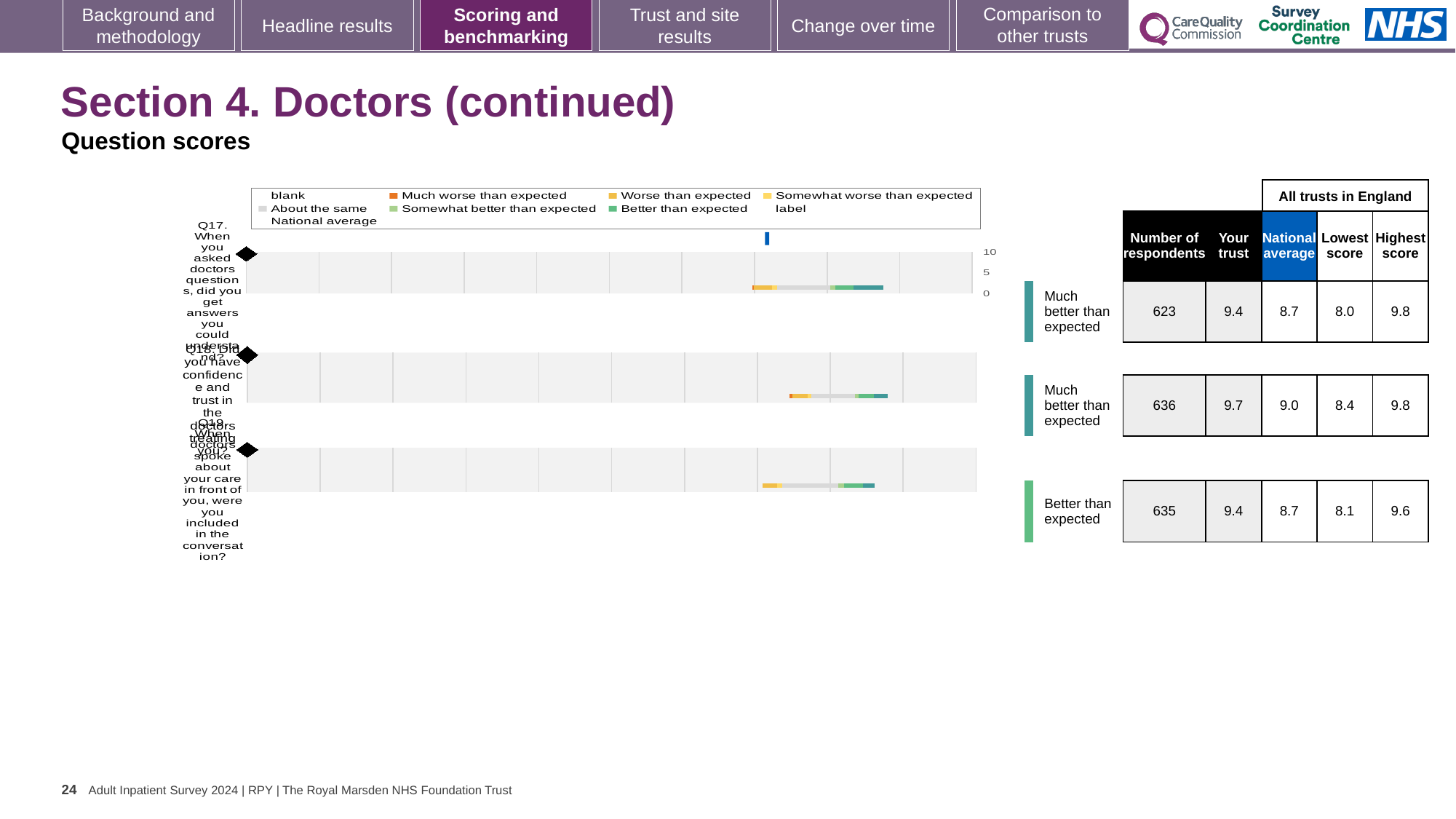
How many respondents answered Q19 (When doctors spoke about your care in front of you, were you included in the conversation)? 635 What is the 'Your trust' score for Q17 (When you asked doctors questions, did you get answers you could understand)? 9.4 Which question has the lowest 'Lowest score' among all trusts in England? Q17 What is the difference between the 'Your trust' score and the national average for Q18? 0.7 How many questions (categories) are plotted in the question scores chart? 3 Which question has the highest 'Your trust' score? Q18 What is the national average score for Q18 (Did you have confidence and trust in the doctors treating you)? 9.0 Is the 'Your trust' score for Q19 greater or less than 5 on the chart axis? greater For Q17, which is larger: the 'Your trust' score or the national average? Your trust What benchmarking category is shown for Q19? Better than expected What kind of chart is used to show the question scores on this slide? bar chart What is the highest score across all trusts in England for Q19? 9.6